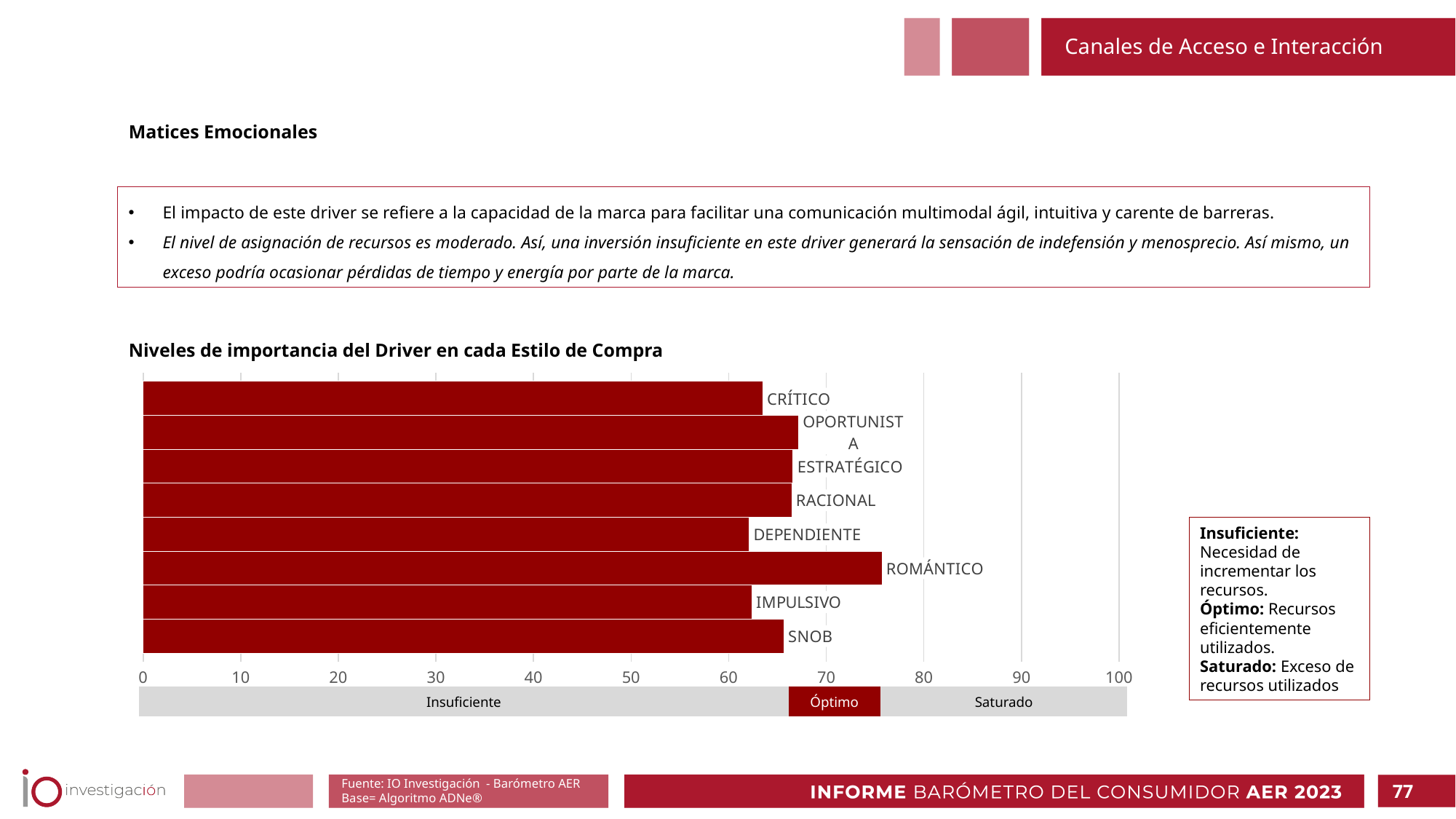
Which purchase style has the highest value in the bar chart? ROMÁNTICO Is the value for CRÍTICO greater or less than 70? less Is the value for ROMÁNTICO greater or less than 70? greater What are the three zone labels shown on the band below the bar chart's axis? Insuficiente, Óptimo, Saturado What kind of chart is shown under "Niveles de importancia del Driver en cada Estilo de Compra"? bar chart Which is larger, the value for ROMÁNTICO or the value for IMPULSIVO? ROMÁNTICO Is the value for SNOB greater or less than 80? less What is the highest value shown on the horizontal axis of the bar chart? 100 Which is larger, the value for OPORTUNISTA or the value for DEPENDIENTE? OPORTUNISTA How many purchase styles (categories) are plotted in the bar chart? 8